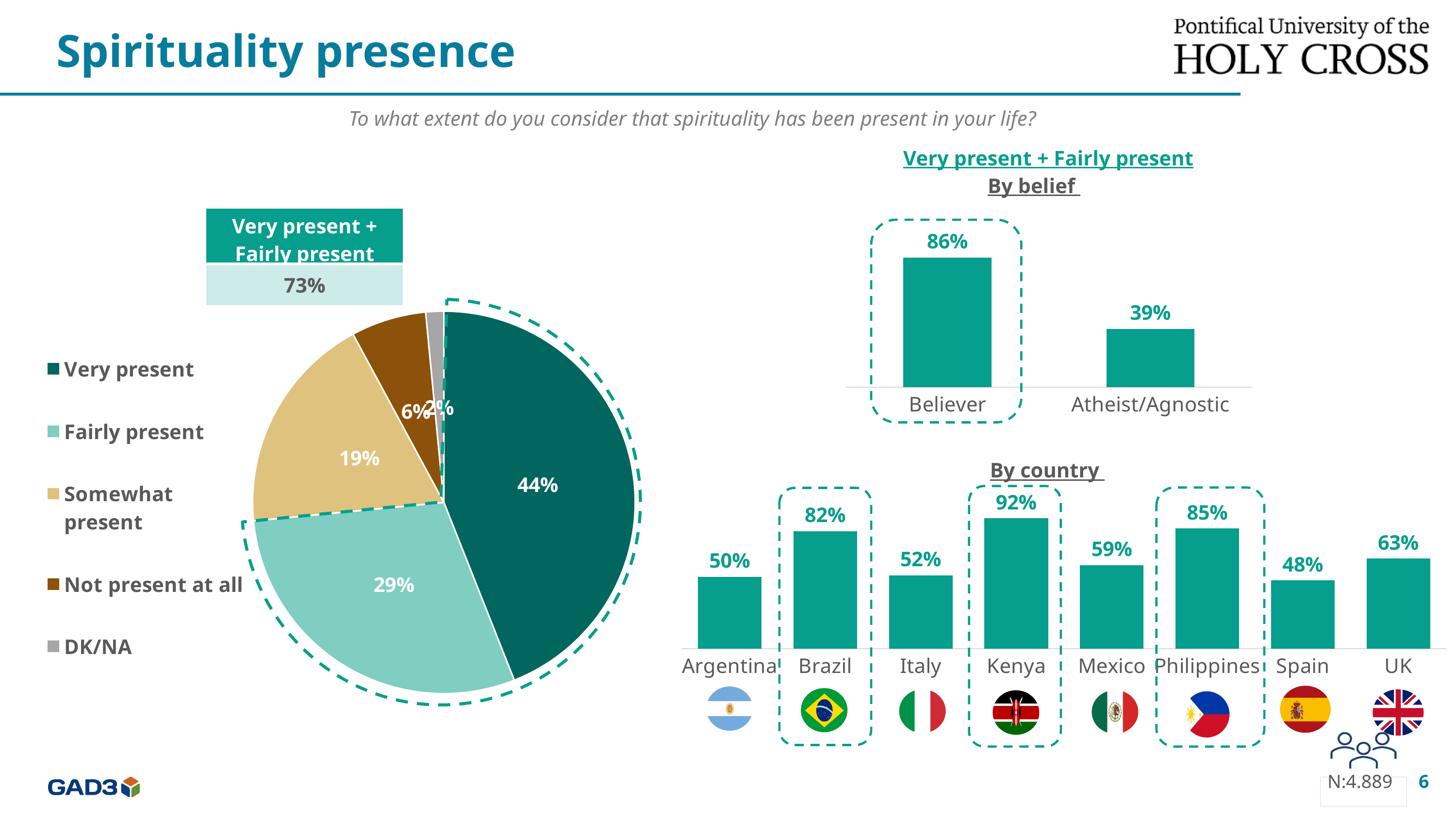
In the 'By country' chart, what is the value for Mexico? 59% What type of chart is the 'By country' chart? Bar chart In the 'By country' chart, which is larger, the value for Brazil or the value for the Philippines? Philippines In the pie chart on the left, what is the difference between the 'Fairly present' and 'Not present at all' shares? 23% In the pie chart on the left, what share of respondents said spirituality was 'Very present'? 44% In the pie chart on the left, which category has the smallest slice? DK/NA In the pie chart on the left, how many categories does the legend list? 5 In the 'By country' chart, which country has the lowest value? Spain In the 'By country' chart, which country has the highest value? Kenya In the pie chart on the left, what share of respondents answered 'Somewhat present'? 19% In the 'By belief' chart, what is the difference between Believer and Atheist/Agnostic? 47% In the 'By belief' chart, what is the value for Atheist/Agnostic? 39%